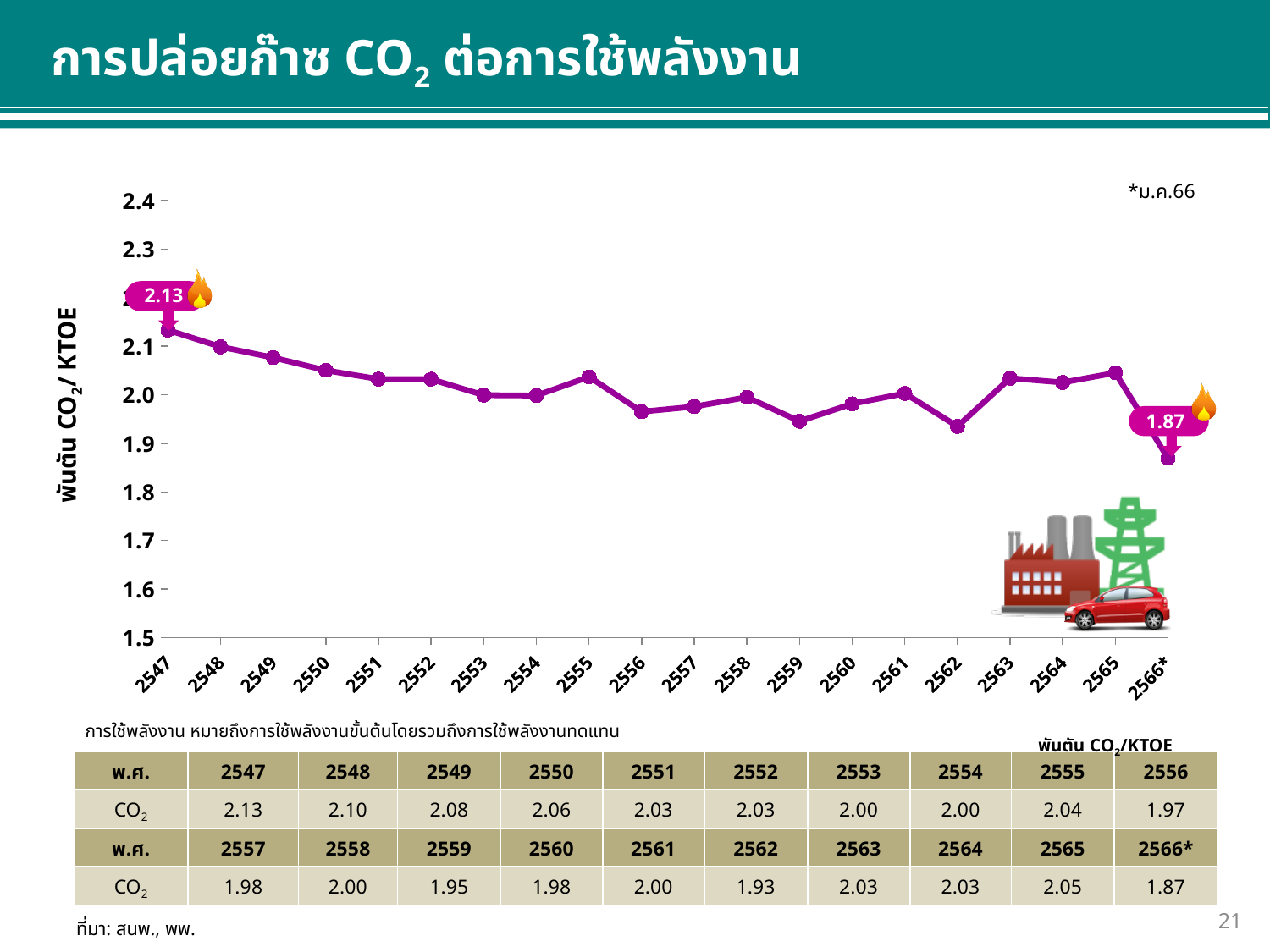
Does the CO2 emission per energy use generally rise or fall from 2547 to 2566*? fall Which year has the larger value, 2562 or 2565? 2565 What is the CO2 emission per energy use value for 2566*? 1.87 What is the CO2 emission per energy use value for 2547? 2.13 How many years (data points) are plotted on the line chart? 20 Which year has the lowest CO2 emission per energy use? 2566* What unit is shown on the y-axis of the chart? พันตัน CO2/ KTOE What is the value for 2562 according to the table? 1.93 What type of chart is shown on the slide? line chart Is the value for 2562 greater or less than 2.0? less Which year has the highest CO2 emission per energy use? 2547 What is the difference between the values for 2547 and 2566*? 0.26